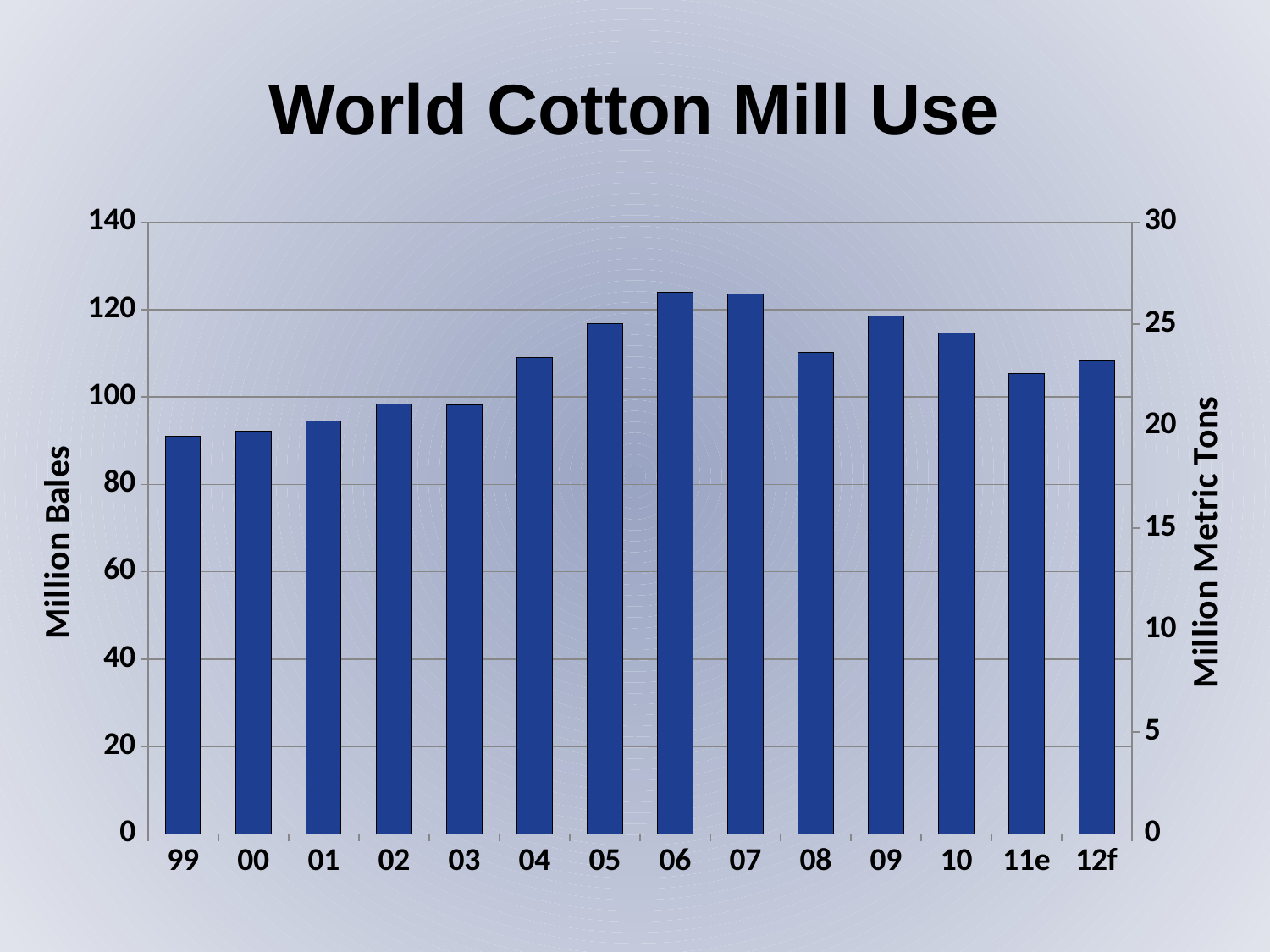
Which year has the larger value, 08 or 09? 09 Is the value for 05 greater or less than 120 million bales? less What kind of chart is shown on the slide? bar chart Is the value for 99 greater or less than 100 million bales? less Is the value for 11e greater or less than 100 million bales? greater How many years (bars) are plotted in the chart? 14 What is the title of the chart? World Cotton Mill Use Do the values generally rise or fall from 99 to 06? rise What is the label of the left vertical axis? Million Bales Which year has the larger value, 03 or 05? 05